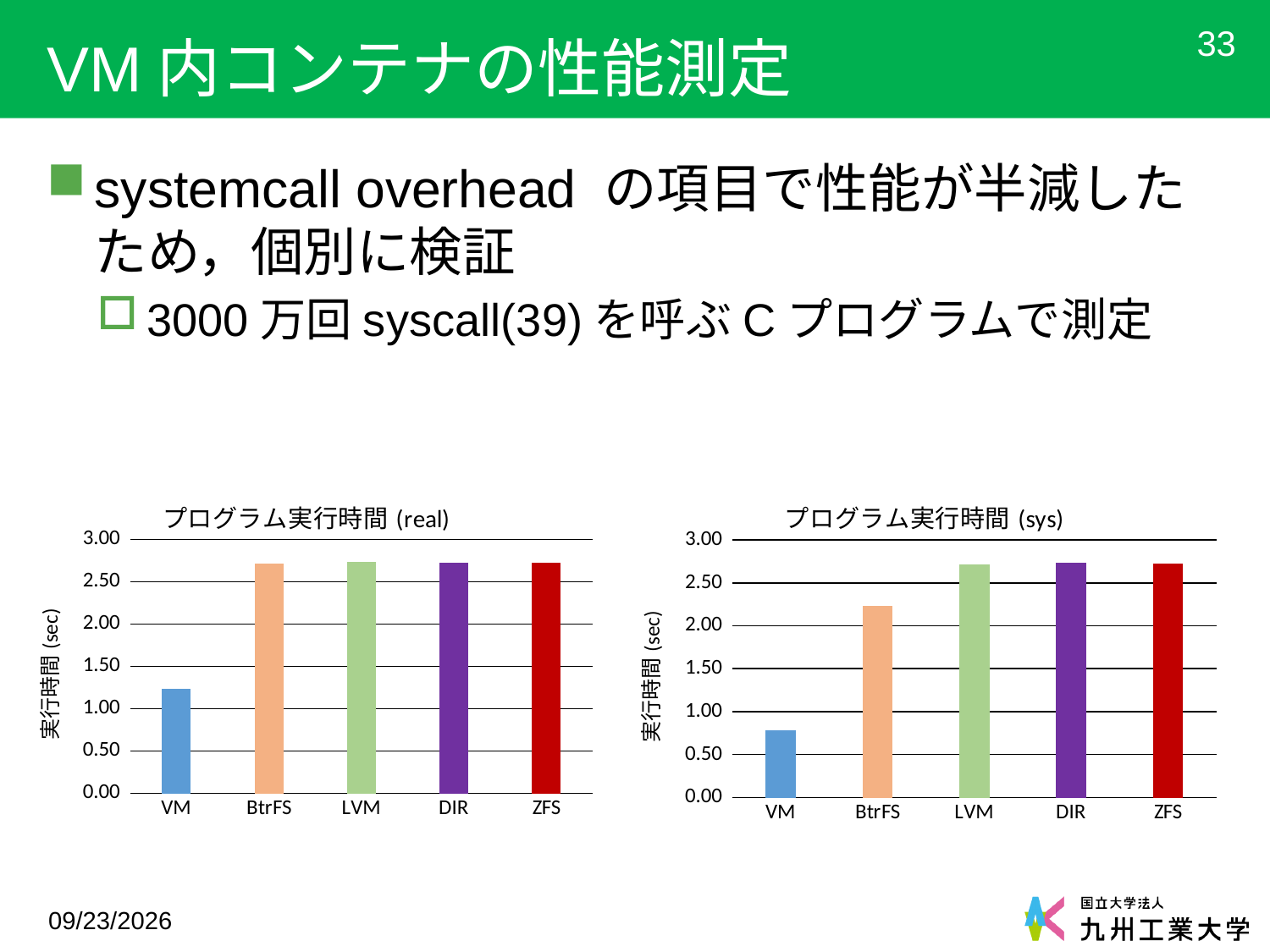
In the chart titled プログラム実行時間 (sys), is the value for BtrFS greater or less than 2.50? less In the chart titled プログラム実行時間 (real), which category has the lowest value? VM What is the y-axis label of the chart titled プログラム実行時間 (real)? 実行時間 (sec) How many categories are shown on the x axis of the chart titled プログラム実行時間 (real)? 5 What kind of chart is the chart titled プログラム実行時間 (sys)? bar chart In the chart titled プログラム実行時間 (real), is the value for VM greater or less than 1.50? less In the chart titled プログラム実行時間 (real), which is larger, the value for VM or the value for DIR? DIR In the chart titled プログラム実行時間 (sys), is the value for VM greater or less than 1.00? less In the chart titled プログラム実行時間 (sys), which is larger, the value for VM or the value for BtrFS? BtrFS In the chart titled プログラム実行時間 (sys), which category has the lowest value? VM